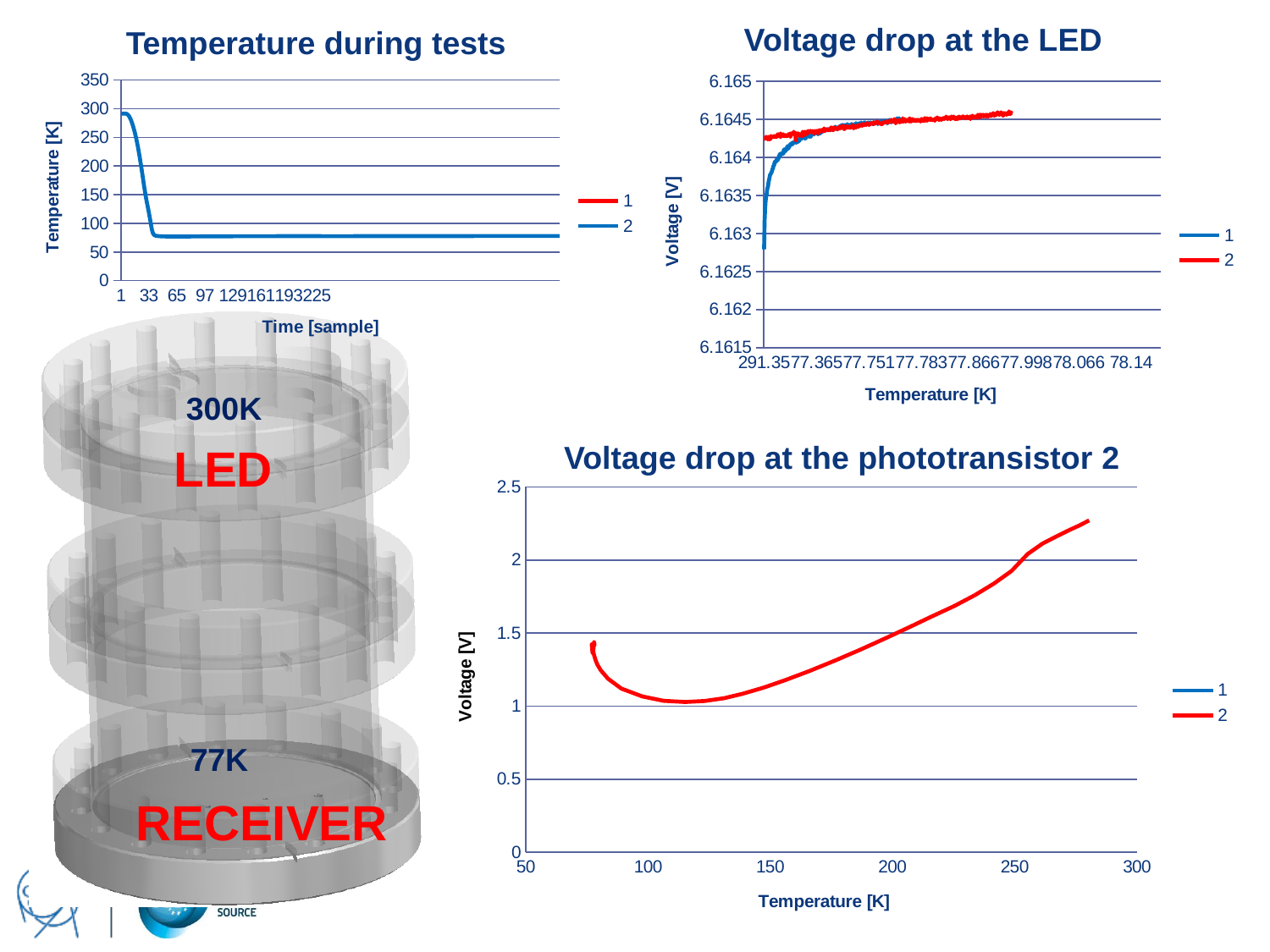
In "Temperature during tests", is the temperature at sample 225 greater or less than 100? less In "Temperature during tests", does the temperature rise or fall over the first samples? fall In "Voltage drop at the phototransistor 2", is the voltage at 100 K greater or less than 1.5? less What kind of chart is "Temperature during tests"? line chart How many series does the legend of "Voltage drop at the LED" list? 2 In "Voltage drop at the LED", is the lowest value of series 1 greater or less than 6.1635? less What kind of chart is "Voltage drop at the phototransistor 2"? line chart How many series does the legend of "Temperature during tests" list? 2 In "Voltage drop at the LED", does series 1 rise or fall along the x axis? rise What is the x-axis title of "Temperature during tests"? Time [sample]